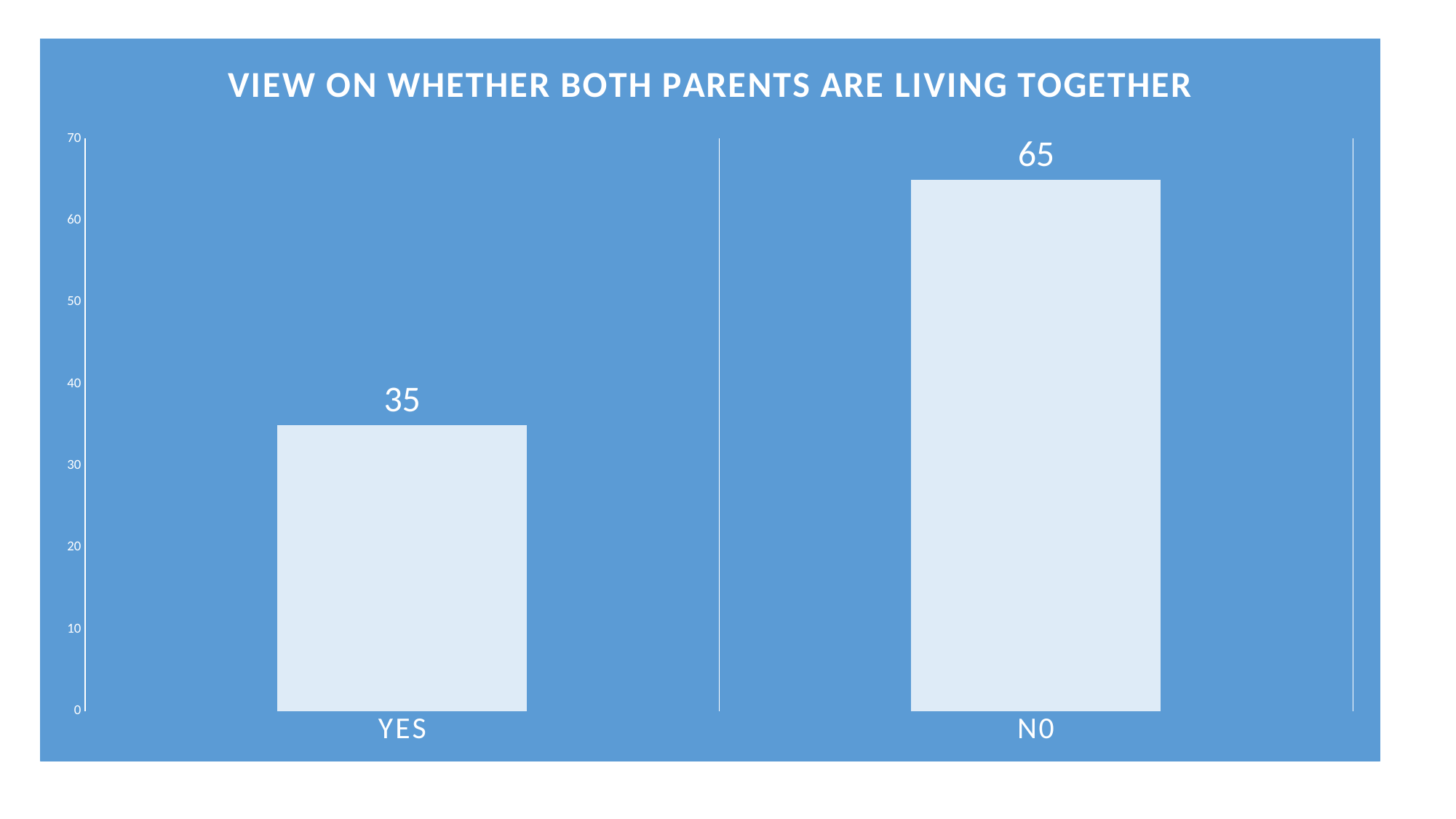
Which category has the lowest value? YES Which is larger, the value for YES or the value for N0? N0 What is the value for N0? 65 Which category has the highest value? N0 What is the difference between the values for N0 and YES? 30 Is the value for YES greater or less than 40? less What is the title of the chart? VIEW ON WHETHER BOTH PARENTS ARE LIVING TOGETHER How many categories are shown on the chart? 2 What is the value for YES? 35 What kind of chart is shown on the slide? bar chart Is the value for N0 greater or less than 60? greater What is the highest value shown on the vertical axis? 70